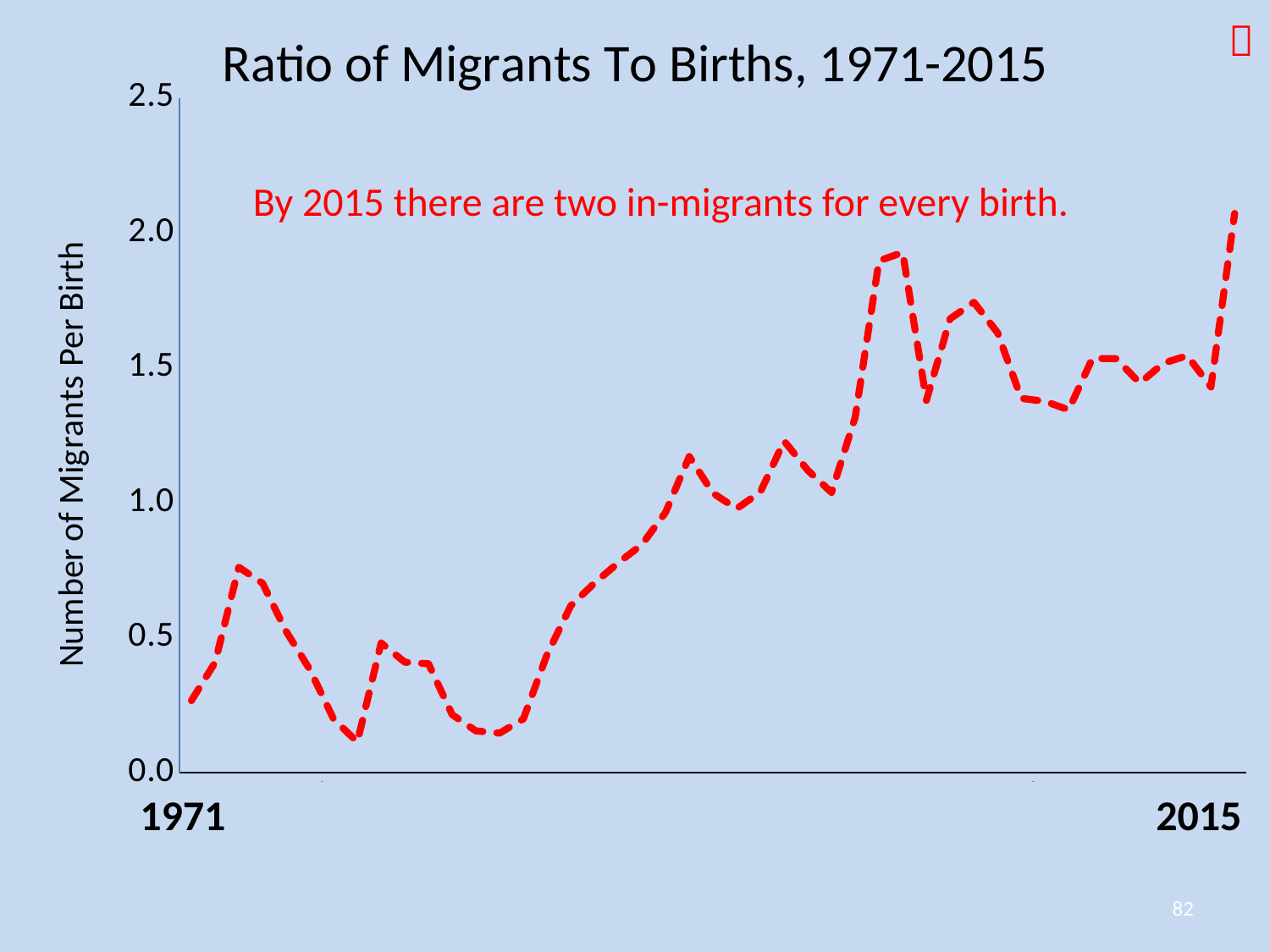
Which year has the larger value, 1971 or 2015? 2015 What is the highest value shown on the vertical axis of the chart? 2.5 Overall, do the values rise or fall from 1971 to 2015? rise Of the two labelled years, 1971 and 2015, which has the lowest value on the chart? 1971 What is the title of the chart? Ratio of Migrants To Births, 1971-2015 Of the two labelled years, 1971 and 2015, which has the highest value on the chart? 2015 Is the value for 1971 greater or less than 1.0? less What is the label on the vertical axis of the chart? Number of Migrants Per Birth What kind of chart is shown on the slide? line chart Is the value for 1971 greater or less than 0.5? less Is the value for 2015 greater or less than 1.5? greater